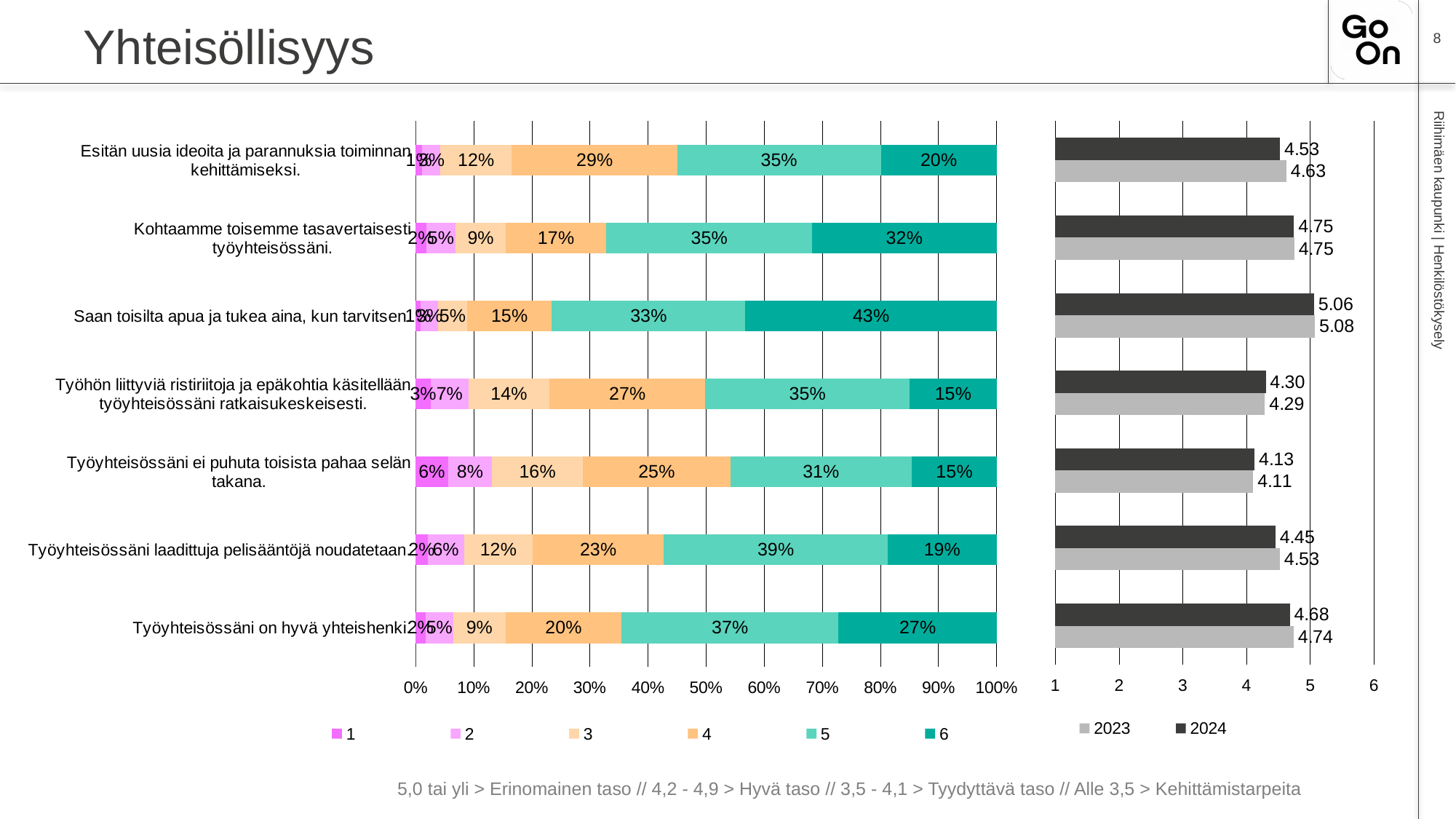
How many series does the legend of the left stacked bar chart list? 6 In the right bar chart, what is the 2023 value for "Työhön liittyviä ristiriitoja ja epäkohtia käsitellään työyhteisössäni ratkaisukeskeisesti"? 4.29 In the right bar chart, what is the 2024 value for "Työyhteisössäni on hyvä yhteishenki"? 4.68 What kind of chart is the chart on the right side of the slide? Bar chart In the right bar chart, what is the difference between the 2023 and 2024 values for "Esitän uusia ideoita ja parannuksia toiminnan kehittämiseksi"? 0.10 In the right bar chart, which statement has the highest 2024 value? Saan toisilta apua ja tukea aina, kun tarvitsen In the left stacked bar chart, which has a larger share of category 6 responses: "Saan toisilta apua ja tukea aina, kun tarvitsen" or "Työyhteisössäni on hyvä yhteishenki"? Saan toisilta apua ja tukea aina, kun tarvitsen In the left stacked bar chart, what percentage of responses for "Saan toisilta apua ja tukea aina, kun tarvitsen" are in category 6? 43% In the left stacked bar chart, what percentage of responses for "Työyhteisössäni ei puhuta toisista pahaa selän takana" are in category 1? 6% How many statements (categories) are shown in the left stacked bar chart? 7 In the right bar chart, which statement has the lowest 2024 value? Työyhteisössäni ei puhuta toisista pahaa selän takana In the left stacked bar chart, what percentage of responses for "Esitän uusia ideoita ja parannuksia toiminnan kehittämiseksi" are in category 4? 29%